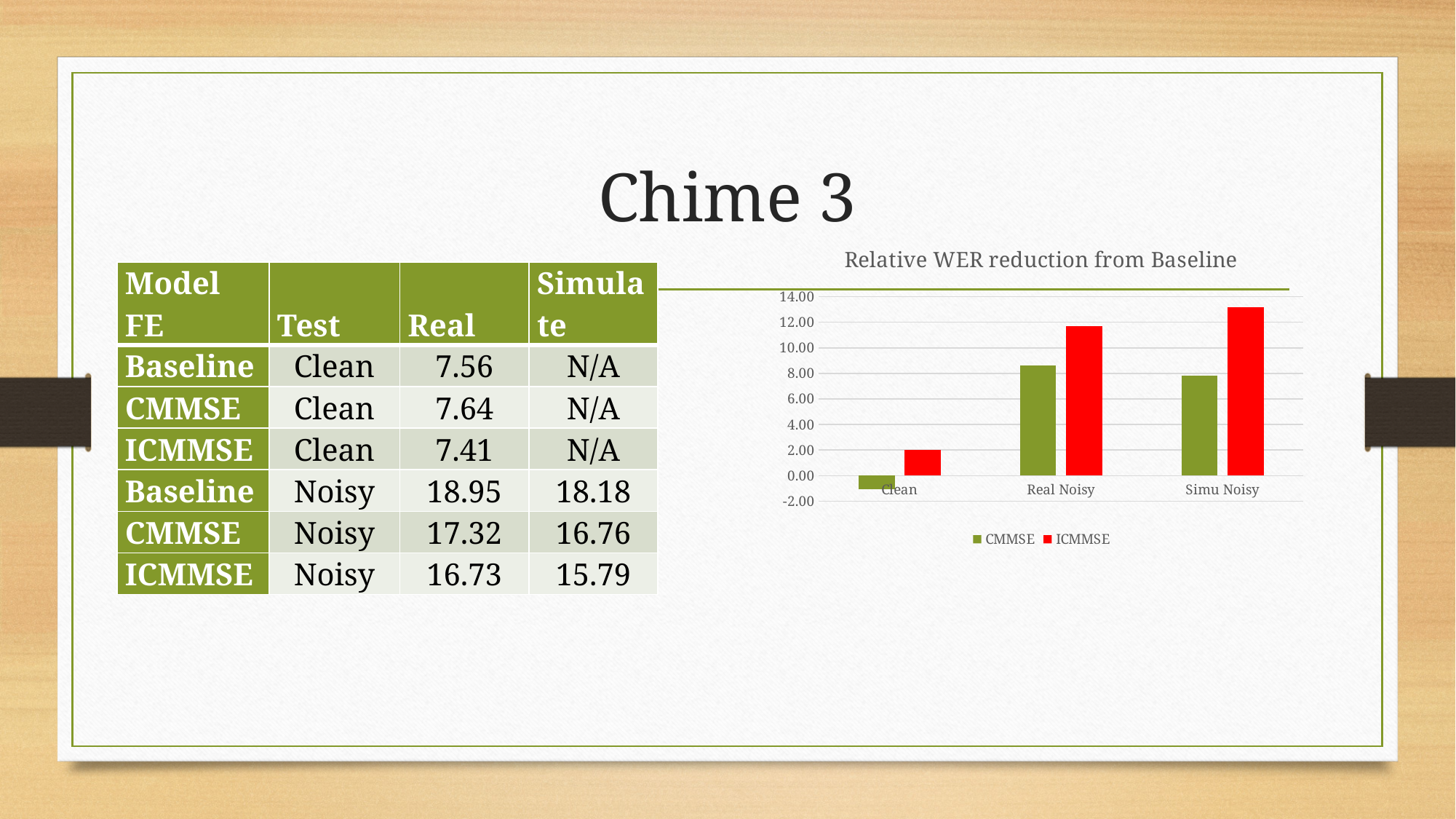
What kind of chart is shown on the slide? bar chart How many series does the chart legend list? 2 Is the ICMMSE value for Simu Noisy greater or less than 12.00? greater Is the CMMSE value for Simu Noisy greater or less than 6.00? greater For Real Noisy, which series has the larger value, CMMSE or ICMMSE? ICMMSE Which colour represents the ICMMSE series in the chart? red For which category is the ICMMSE bar the highest? Simu Noisy How many categories are shown on the x axis of the chart? 3 What is the title of the chart? Relative WER reduction from Baseline Is the ICMMSE value for Real Noisy greater or less than 10.00? greater For which category is the CMMSE bar the lowest? Clean